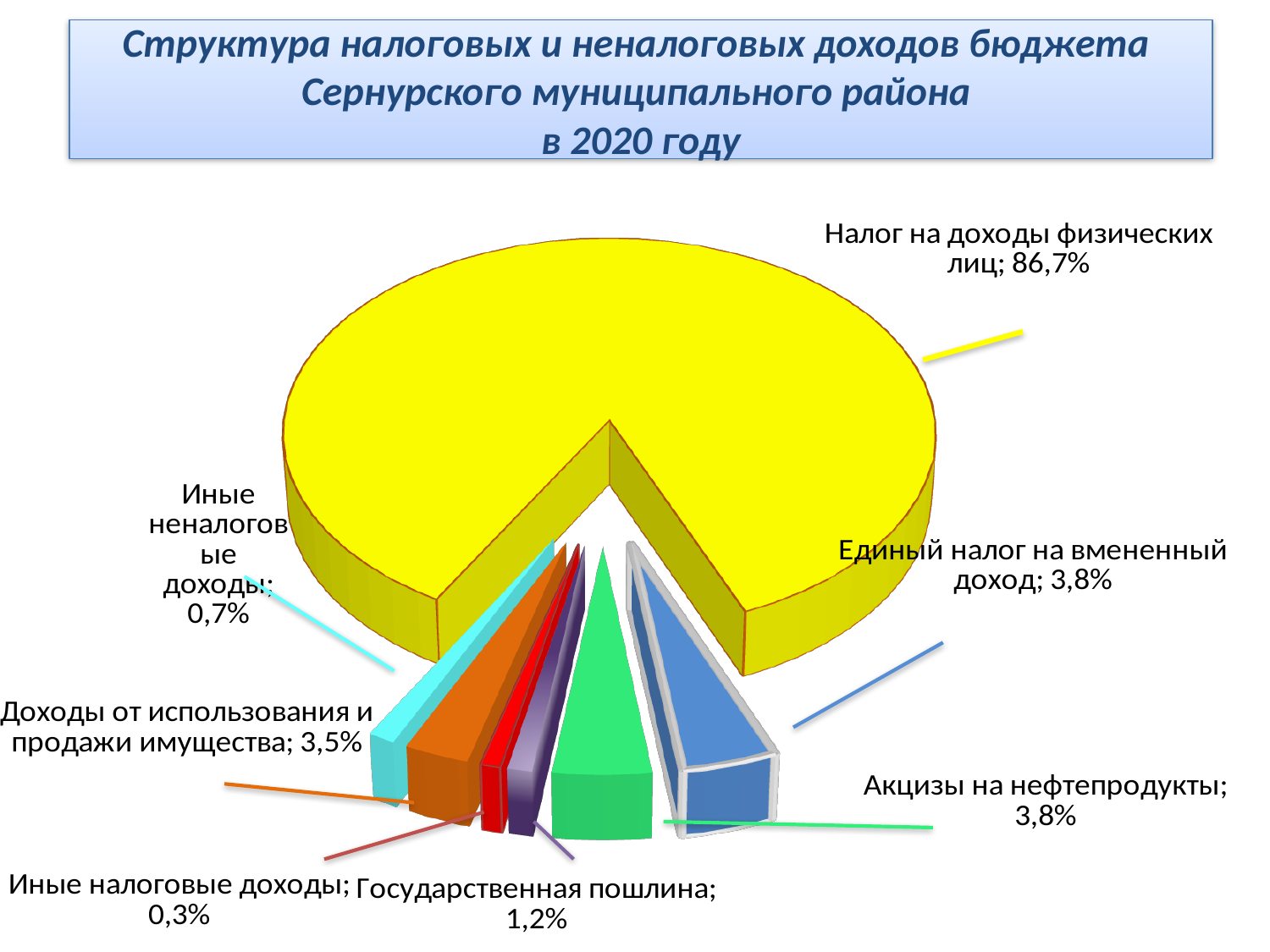
What share does "Иные налоговые доходы" have in the pie chart? 0,3% What is the difference between the shares of "Налог на доходы физических лиц" and "Единый налог на вмененный доход"? 82,9% What share does "Единый налог на вмененный доход" have in the pie chart? 3,8% What share does "Иные неналоговые доходы" have in the pie chart? 0,7% How many slices does the pie chart have? 7 Which category has the largest share in the pie chart? Налог на доходы физических лиц What type of chart is shown on the slide? Pie chart What share does "Налог на доходы физических лиц" have in the pie chart? 86,7% What share does "Государственная пошлина" have in the pie chart? 1,2% Which category has the smallest share in the pie chart? Иные налоговые доходы What share does "Доходы от использования и продажи имущества" have in the pie chart? 3,5% Which is larger: the share of "Доходы от использования и продажи имущества" or the share of "Государственная пошлина"? Доходы от использования и продажи имущества